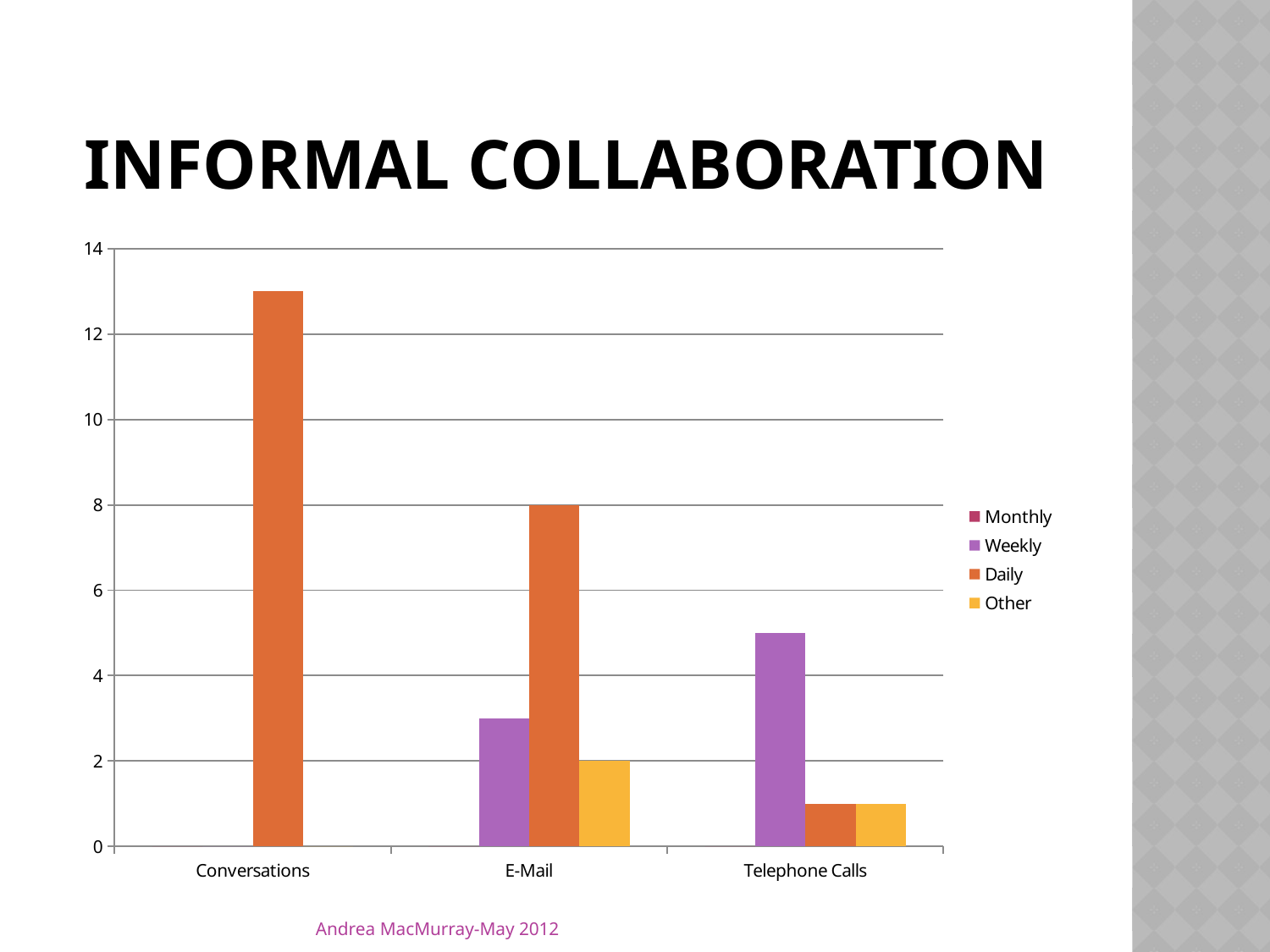
What is the Daily value for E-Mail? 8 How many categories are shown on the x axis? 3 Is the Weekly value for Telephone Calls greater or less than 4? greater Is the Daily value for Telephone Calls greater or less than 2? less What type of chart is shown on the slide? Bar chart What is the Other value for E-Mail? 2 Which has the larger Weekly value, E-Mail or Telephone Calls? Telephone Calls Is the Daily value for Conversations greater or less than 12? greater What is the title of the slide containing the chart? Informal Collaboration How many series does the legend list? 4 Which category has the highest Daily value? Conversations What is the difference between the Daily and Other values for E-Mail? 6